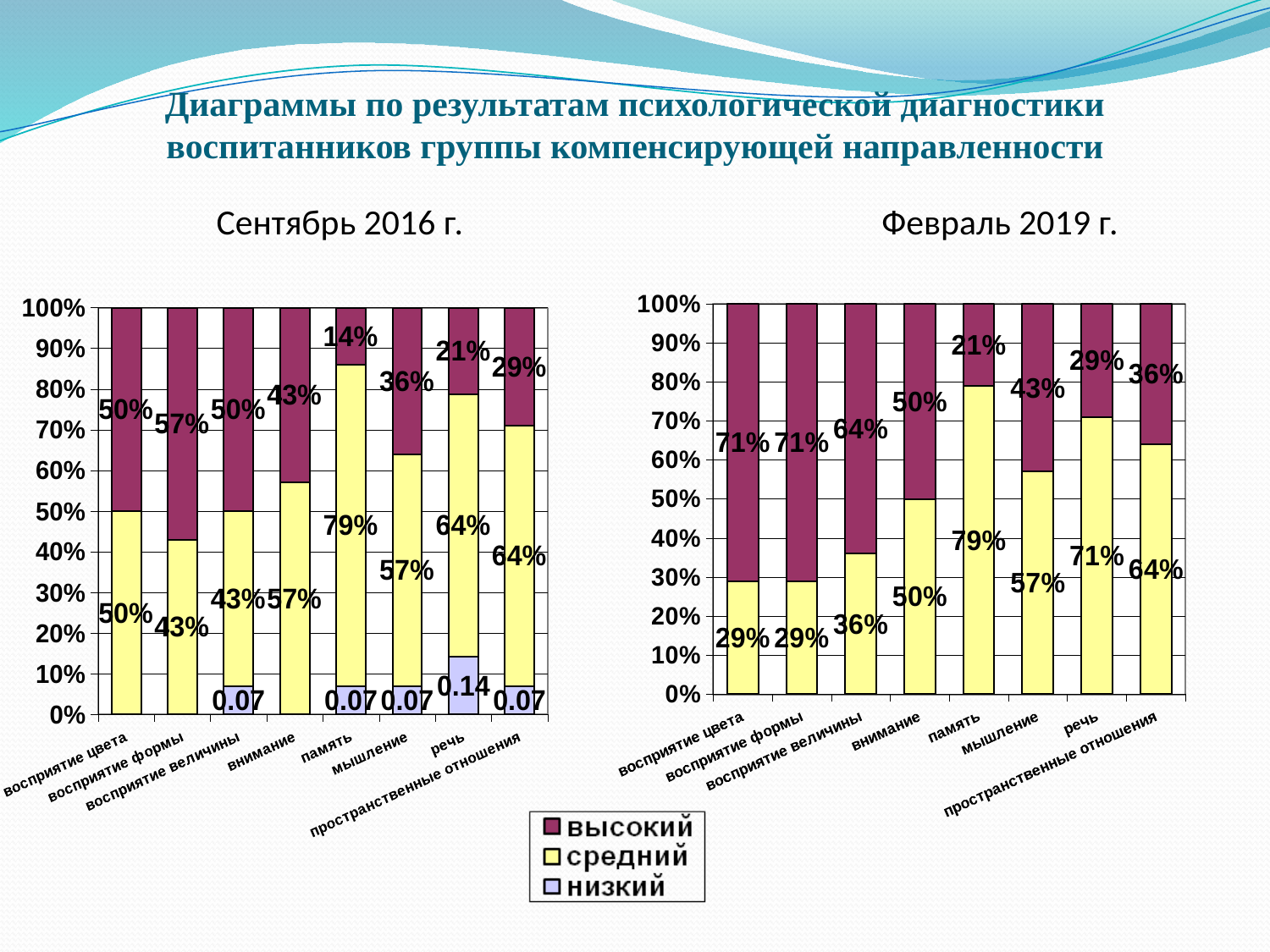
In the 'Сентябрь 2016 г.' chart, what is the value of 'средний' for 'память'? 79% In the 'Февраль 2019 г.' chart, which category has the lowest 'высокий' value? память In the 'Сентябрь 2016 г.' chart, which category has the highest 'средний' value? память In the 'Сентябрь 2016 г.' chart, what is the value of 'низкий' for 'речь'? 0.14 How many categories are shown on the x axis of the 'Февраль 2019 г.' chart? 8 What type of chart is the 'Сентябрь 2016 г.' chart? Stacked bar chart How many series does the legend list? 3 In the 'Февраль 2019 г.' chart, what is the value of 'средний' for 'речь'? 71% In the 'Февраль 2019 г.' chart, what is the value of 'высокий' for 'восприятие цвета'? 71% In the 'Сентябрь 2016 г.' chart, which is larger: the 'высокий' value for 'восприятие формы' or for 'мышление'? восприятие формы In the 'Февраль 2019 г.' chart, what is the difference between the 'высокий' values for 'восприятие формы' and 'мышление'? 28% Which colour represents the 'средний' series in the legend? Yellow